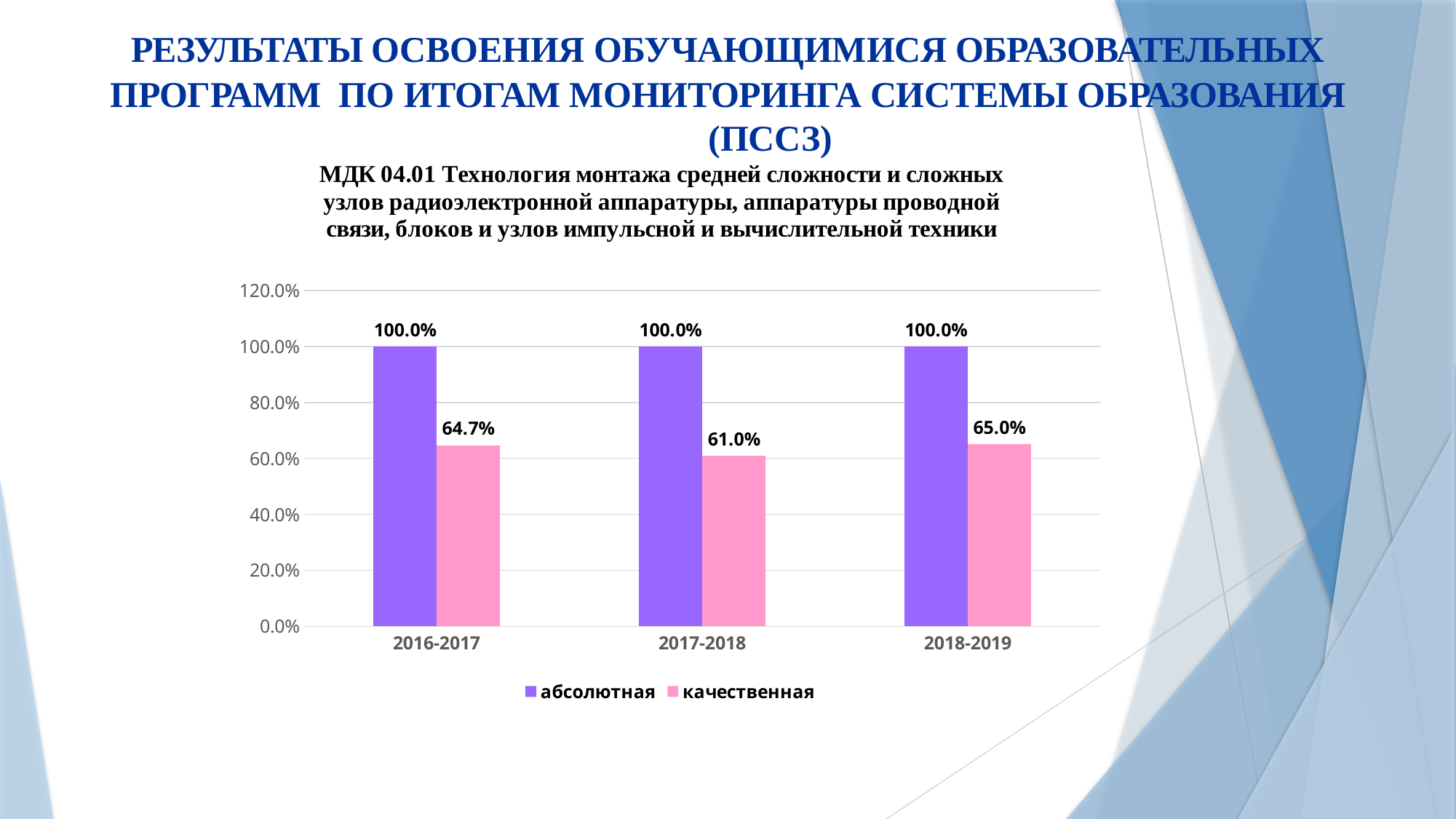
Which is larger: the качественная value for 2016-2017 or for 2017-2018? 2016-2017 In which academic year is the качественная value lowest? 2017-2018 What is the value of the качественная series for 2017-2018? 61.0% What is the value of the абсолютная series for 2018-2019? 100.0% In which academic year is the качественная value highest? 2018-2019 How many academic years are shown on the x axis? 3 What is the value of the качественная series for 2016-2017? 64.7% What kind of chart is shown on the slide? bar chart Is the качественная value for 2017-2018 greater or less than 80.0%? less How many series does the legend list? 2 What is the difference between the абсолютная and качественная values for 2017-2018? 39.0% What is the difference between the качественная values for 2018-2019 and 2017-2018? 4.0%